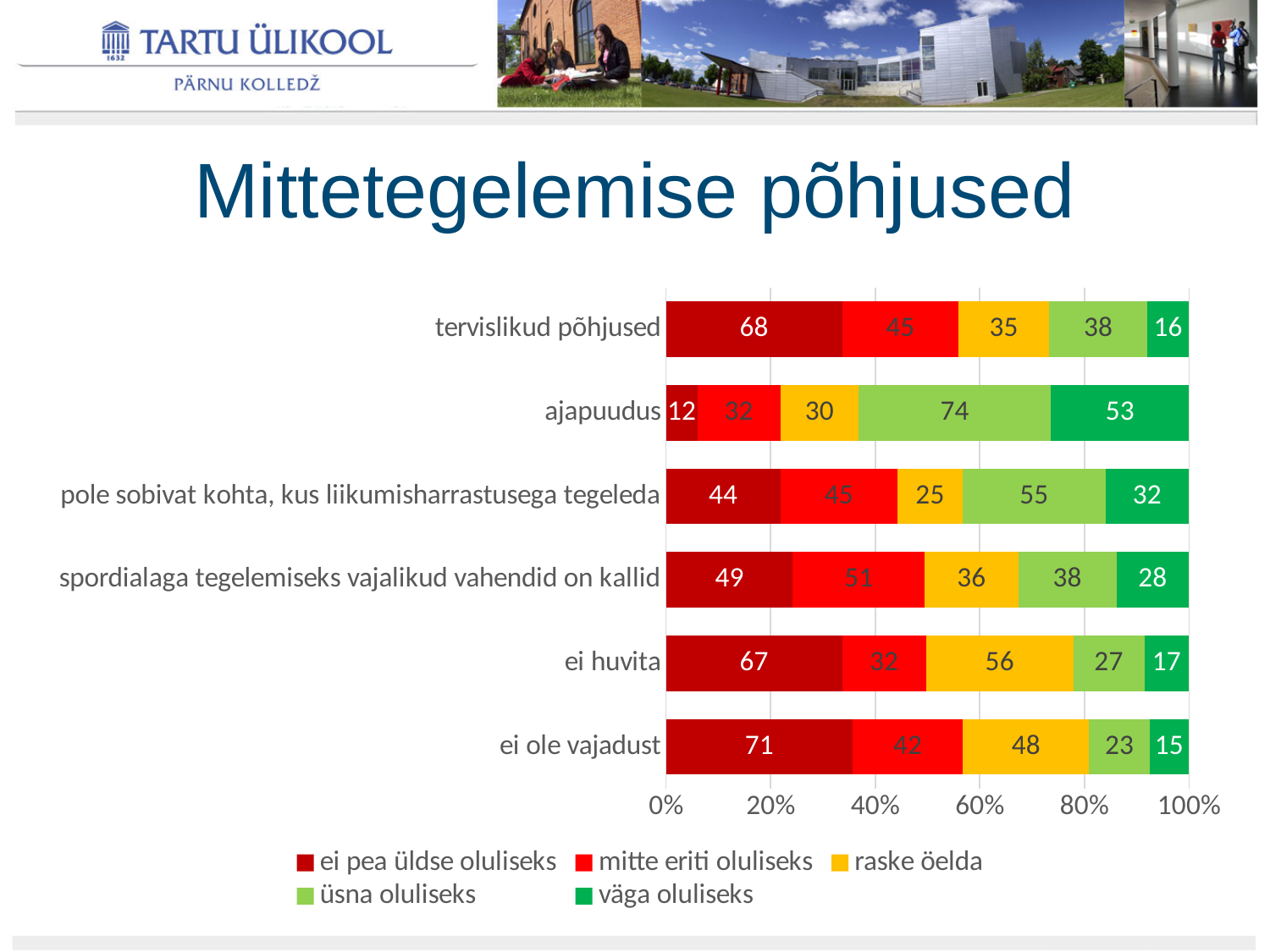
What is the value of 'väga oluliseks' for 'pole sobivat kohta, kus liikumisharrastusega tegeleda'? 32 How many categories (reasons) are shown on the chart? 6 Which category has the highest value for 'ei pea üldse oluliseks'? ei ole vajadust What is the difference between the 'ei pea üldse oluliseks' values for 'ei ole vajadust' and 'ajapuudus'? 59 Which category has the lowest value for 'väga oluliseks'? ei ole vajadust How many series does the legend list? 5 Which is larger: the 'mitte eriti oluliseks' value for 'spordialaga tegelemiseks vajalikud vahendid on kallid' or for 'ei huvita'? spordialaga tegelemiseks vajalikud vahendid on kallid What is the value of 'ei pea üldse oluliseks' for 'tervislikud põhjused'? 68 What is the total of all segments in the 'ajapuudus' bar? 201 What is the value of 'üsna oluliseks' for 'ajapuudus'? 74 What type of chart is shown on the slide? stacked bar chart What is the value of 'raske öelda' for 'ei huvita'? 56